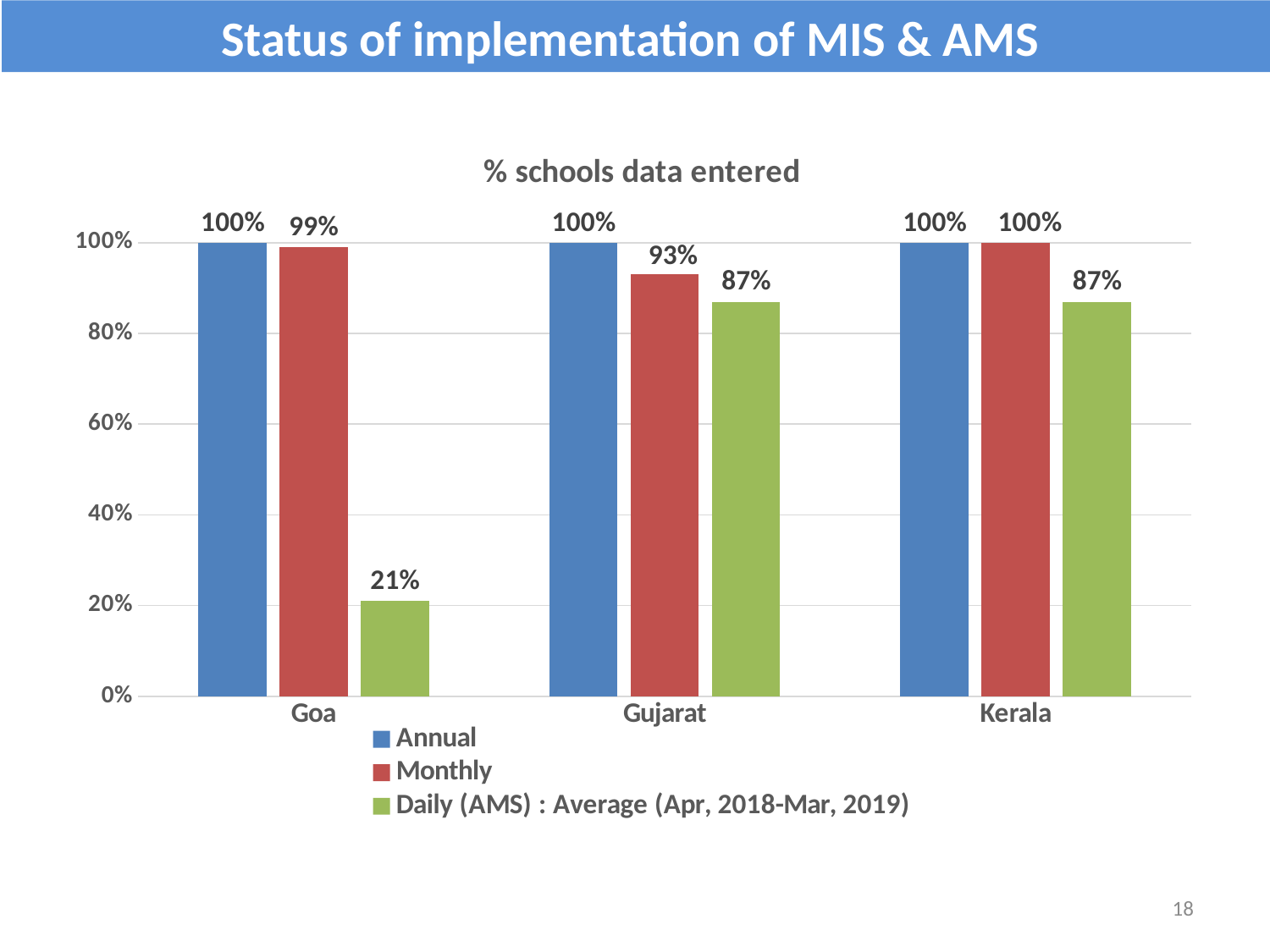
Which state has the lowest Monthly value? Gujarat Which is larger for Gujarat, the Monthly value or the Daily (AMS) value? Monthly What is the Monthly value for Kerala? 100% What is the Monthly value for Gujarat? 93% How many series does the legend list? 3 What type of chart is shown? bar chart What is the Daily (AMS) value for Gujarat? 87% Which state has the lowest Daily (AMS) value? Goa How many states are shown on the x axis? 3 What is the difference between the Monthly and Daily (AMS) values for Goa? 78% What is the Daily (AMS) value for Goa? 21% Is the Daily (AMS) value for Goa greater or less than 40%? less